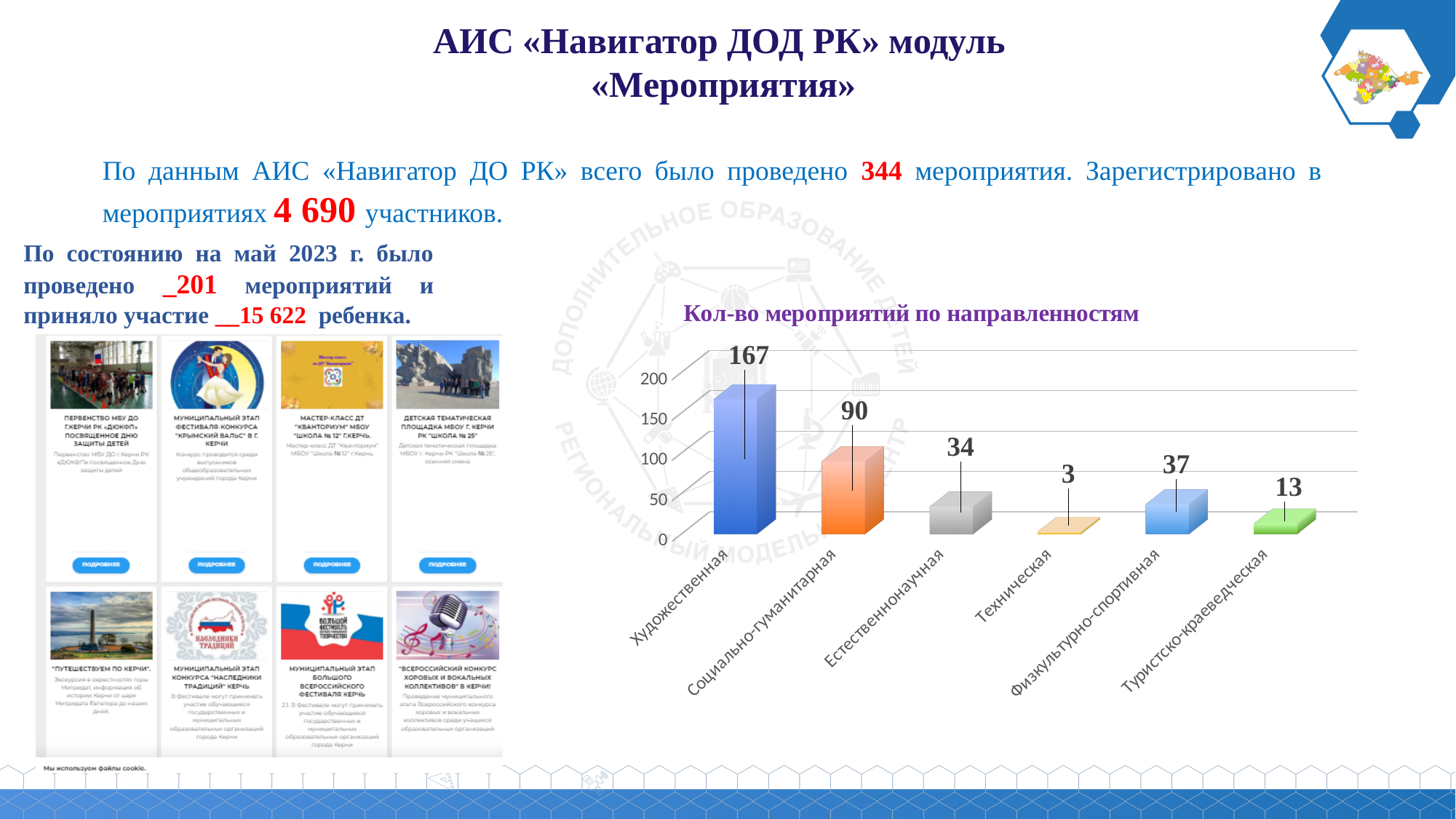
Which category has the lowest value in the chart? Техническая Which category has the highest value in the chart? Художественная What is the value for Художественная in the chart? 167 What is the title of the chart? Кол-во мероприятий по направленностям What is the value for Туристско-краеведческая in the chart? 13 What is the value for Социально-гуманитарная in the chart? 90 What is the value for Физкультурно-спортивная in the chart? 37 What kind of chart is shown on the slide? Bar chart What is the difference between the values for Художественная and Социально-гуманитарная? 77 Which is larger, the value for Естественнонаучная or the value for Туристско-краеведческая? Естественнонаучная What is the difference between the values for Физкультурно-спортивная and Естественнонаучная? 3 How many categories are shown in the chart? 6